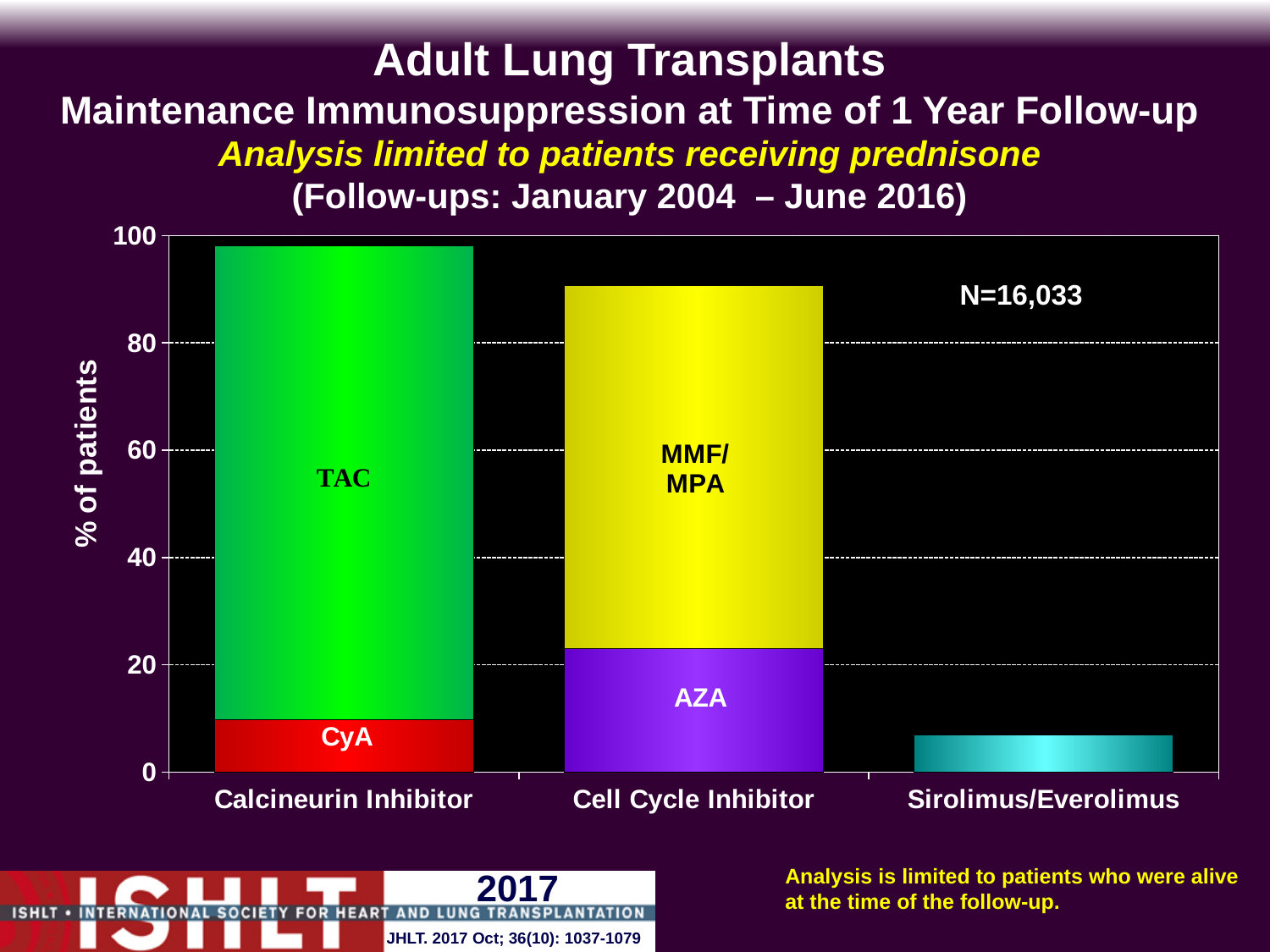
Which category has the tallest bar? Calcineurin Inhibitor Which category has the shortest bar? Sirolimus/Everolimus Is the CyA segment of the Calcineurin Inhibitor bar greater or less than 20? less What kind of chart is shown on the slide? bar chart What is the label on the y axis? % of patients Which segment is larger within the Cell Cycle Inhibitor bar, MMF/MPA or AZA? MMF/MPA Is the value for Sirolimus/Everolimus greater or less than 20? less What is the N value shown on the chart? N=16,033 Is the AZA segment of the Cell Cycle Inhibitor bar greater or less than 40? less How many categories are shown on the x axis? 3 Which segment is larger within the Calcineurin Inhibitor bar, TAC or CyA? TAC